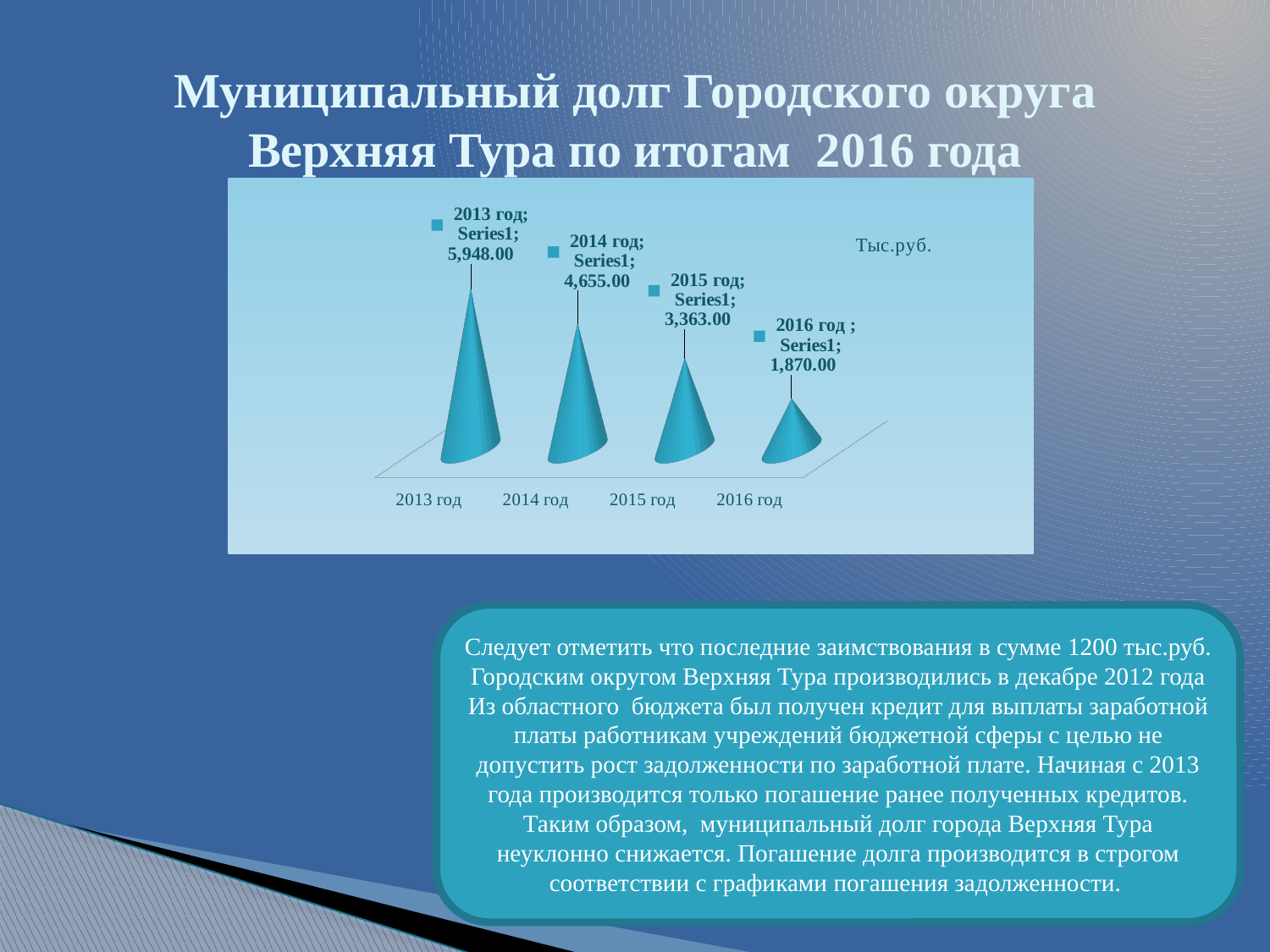
Which is larger, the value for 2014 год or the value for 2015 год? 2014 год Do the values rise or fall from 2013 год to 2016 год? fall What is the value for 2016 год? 1,870.00 What is the value for 2013 год? 5,948.00 Which year has the highest value? 2013 год What is the difference between the values for 2014 год and 2015 год? 1,292.00 What unit is indicated on the chart? Тыс.руб. How many years are shown on the chart? 4 What is the difference between the values for 2013 год and 2016 год? 4,078.00 What is the value for 2015 год? 3,363.00 What is the value for 2014 год? 4,655.00 Which year has the lowest value? 2016 год